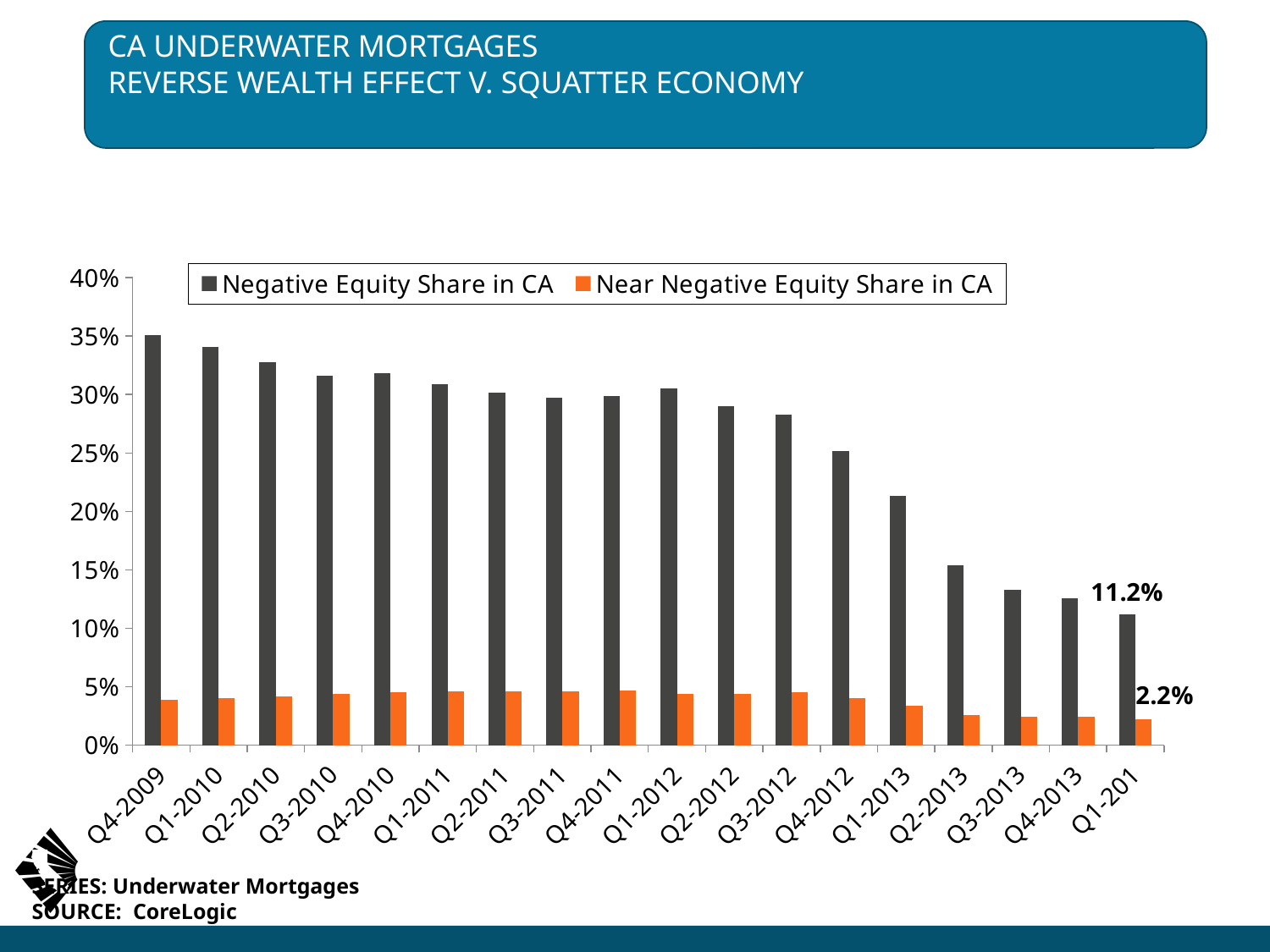
Which is larger, the Negative Equity Share in CA for Q4-2009 or for Q4-2013? Q4-2009 Does the Negative Equity Share in CA generally rise or fall from Q4-2009 to the last quarter shown? Fall What is the Near Negative Equity Share in CA for the last quarter shown (the rightmost bar)? 2.2% Is the Negative Equity Share in CA for Q1-2013 greater or less than 20%? greater What colour are the bars for Near Negative Equity Share in CA? Orange How many quarters are shown along the x axis of the chart? 18 What kind of chart is shown on the slide? Bar chart Is the Negative Equity Share in CA for Q3-2013 greater or less than 15%? less For the last quarter shown, what is the difference between the Negative Equity Share in CA and the Near Negative Equity Share in CA? 9.0% How many series does the chart's legend list? 2 What is the Negative Equity Share in CA for the last quarter shown (the rightmost bar)? 11.2% In which quarter is the Negative Equity Share in CA highest? Q4-2009